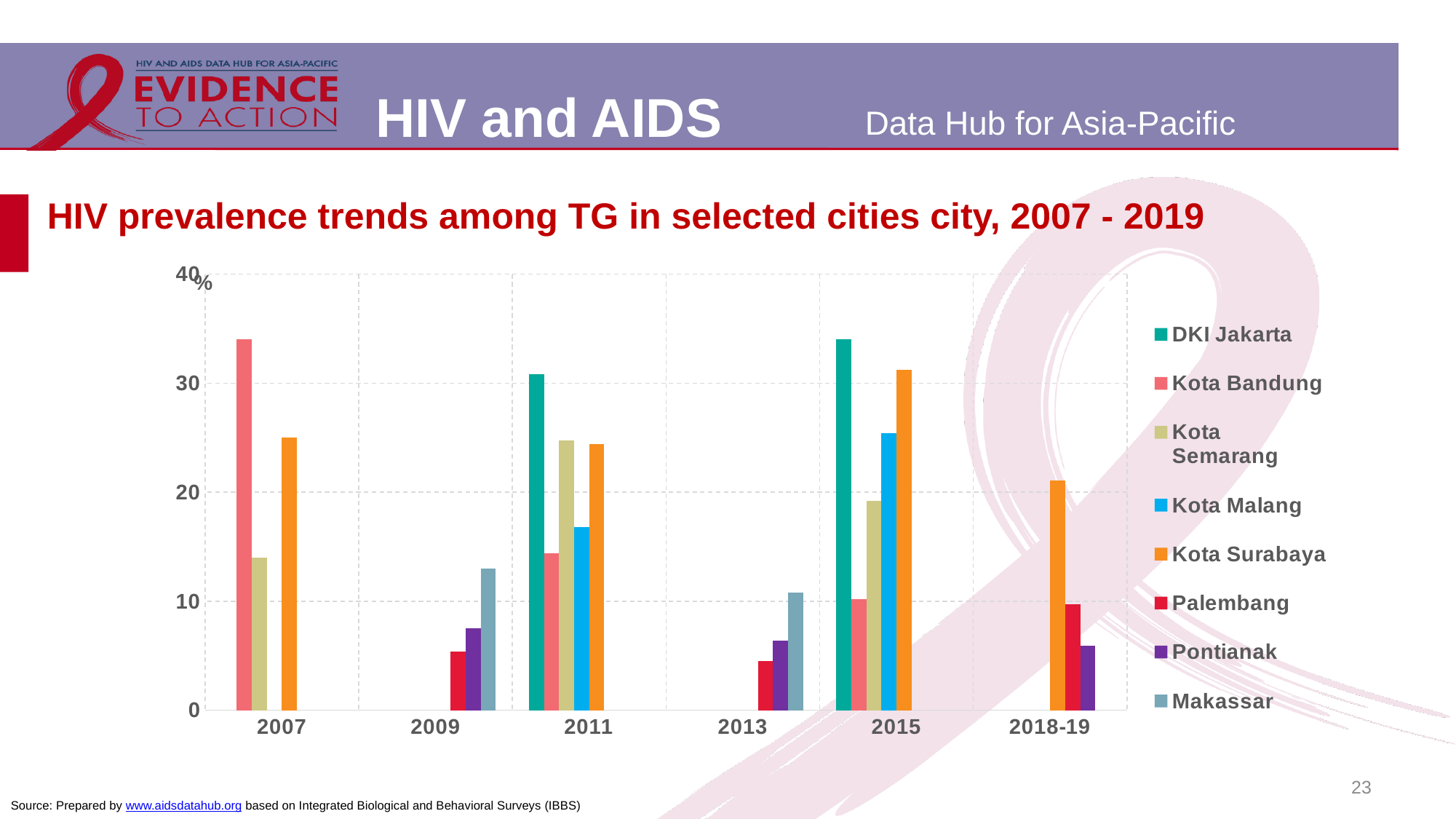
Is the value for Kota Bandung in 2007 greater or less than 30? greater What kind of chart is shown on the slide? bar chart Is the value for Makassar in 2009 greater or less than 10? greater How many series does the legend list? 8 What is the title of the chart? HIV prevalence trends among TG in selected cities city, 2007 - 2019 Does the value for Kota Bandung rise or fall from 2007 to 2015? fall Which city has the lowest HIV prevalence in 2015? Kota Bandung How many year categories are shown on the x axis? 6 Is the value for Kota Malang in 2015 greater or less than 20? greater Which city has the highest HIV prevalence in 2011? DKI Jakarta In 2007, which is larger: the value for Kota Surabaya or Kota Semarang? Kota Surabaya